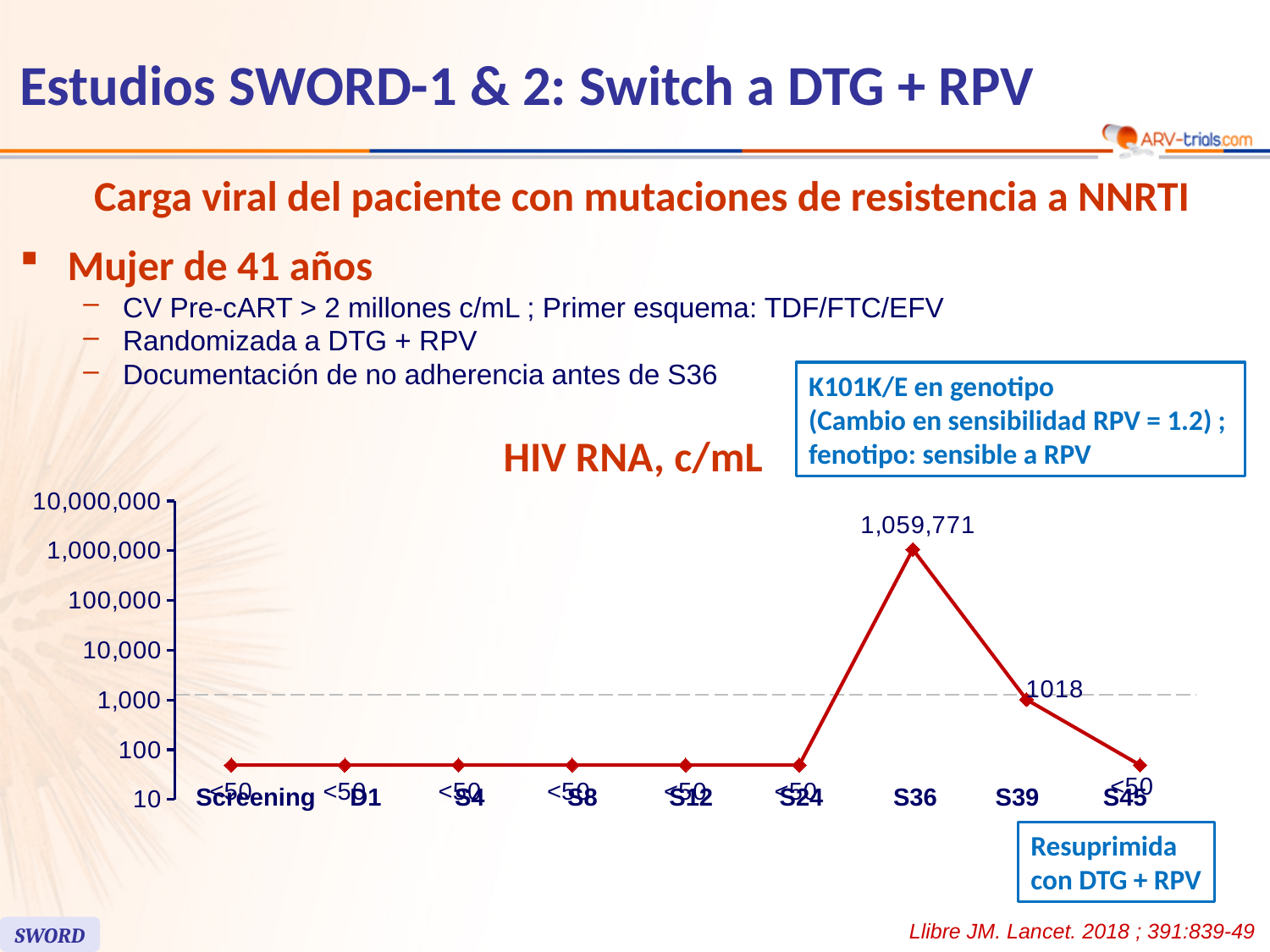
How many time points are plotted on the x axis? 9 Is the HIV RNA value at S36 greater or less than 100,000? greater What is the HIV RNA value shown at S45? <50 What kind of chart is used to show HIV RNA, c/mL? line chart Which is larger, the HIV RNA value at S36 or at S39? S36 What is the title of the chart? HIV RNA, c/mL What is the HIV RNA value at S36? 1,059,771 Do the HIV RNA values rise or fall from S36 to S45? fall Is the HIV RNA value at S39 greater or less than 100? greater At which time point is the HIV RNA value highest? S36 What is the difference between the HIV RNA values at S36 and S39? 1,058,753 What is the HIV RNA value at S39? 1018